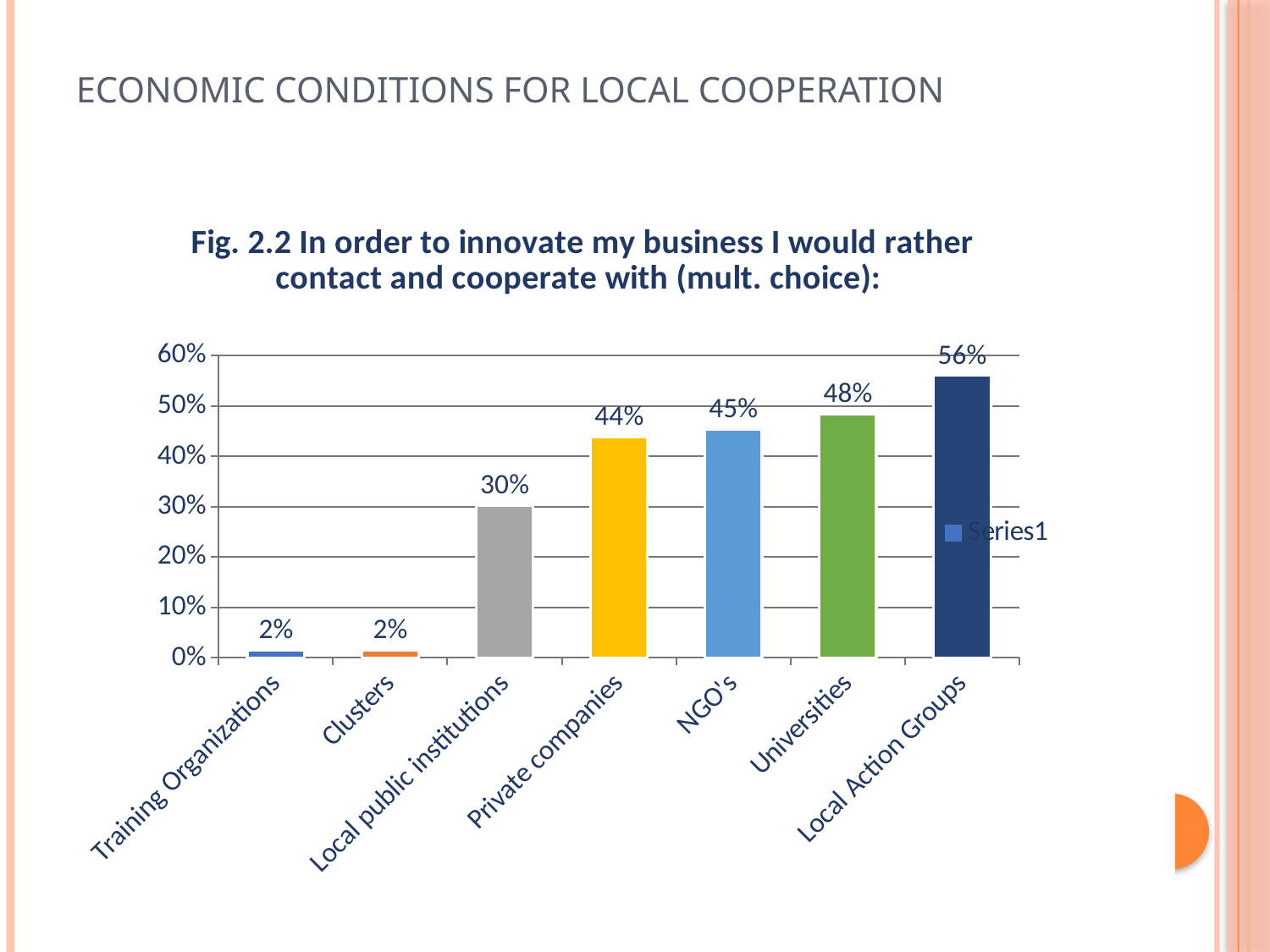
What is the difference between the values for Local Action Groups and Private companies? 12% Do the values generally rise or fall from left to right along the x axis? rise How many categories are shown on the x axis? 7 What is the value for Universities? 48% Which category has the highest value? Local Action Groups How many series does the legend list? 1 Is the value for Private companies greater or less than 40%? greater What is the value for Local public institutions? 30% Which is larger, the value for NGO's or the value for Local public institutions? NGO's What is the difference between the values for Universities and Local public institutions? 18% What is the value for Local Action Groups? 56% What kind of chart is shown? bar chart